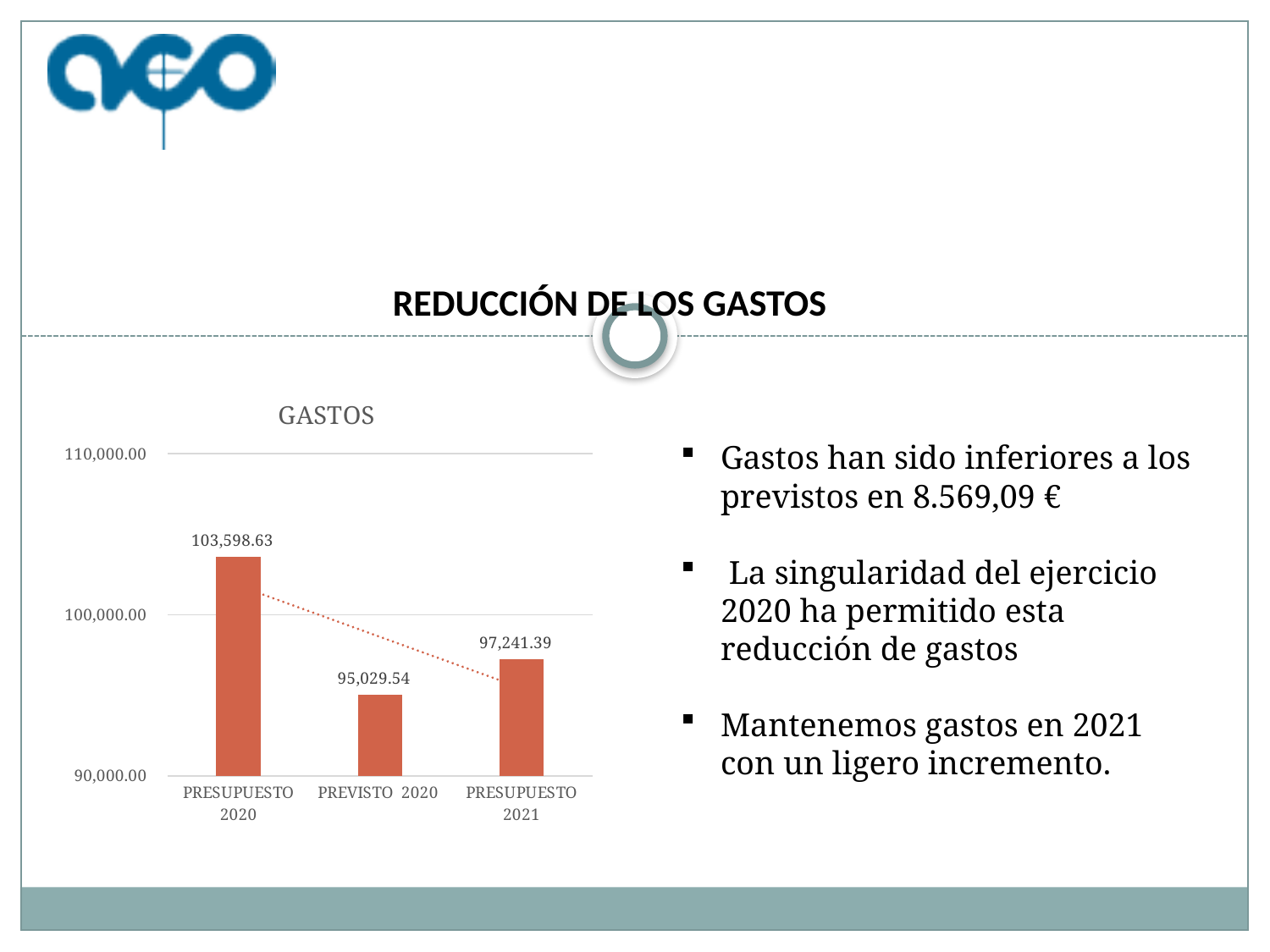
What is the difference between PRESUPUESTO 2020 and PREVISTO 2020 in the GASTOS chart? 8,569.09 What kind of chart is the GASTOS chart? bar chart What is the value for PREVISTO 2020 in the GASTOS chart? 95,029.54 What is the difference between PRESUPUESTO 2021 and PREVISTO 2020 in the GASTOS chart? 2,211.85 How many categories are shown in the GASTOS chart? 3 Which category has the lowest value in the GASTOS chart? PREVISTO 2020 Is the value for PRESUPUESTO 2020 greater or less than 100,000.00? greater Which is larger in the GASTOS chart, PRESUPUESTO 2021 or PREVISTO 2020? PRESUPUESTO 2021 Which category has the highest value in the GASTOS chart? PRESUPUESTO 2020 What is the value for PRESUPUESTO 2021 in the GASTOS chart? 97,241.39 What is the value for PRESUPUESTO 2020 in the GASTOS chart? 103,598.63 What is the title of the chart on the slide? GASTOS